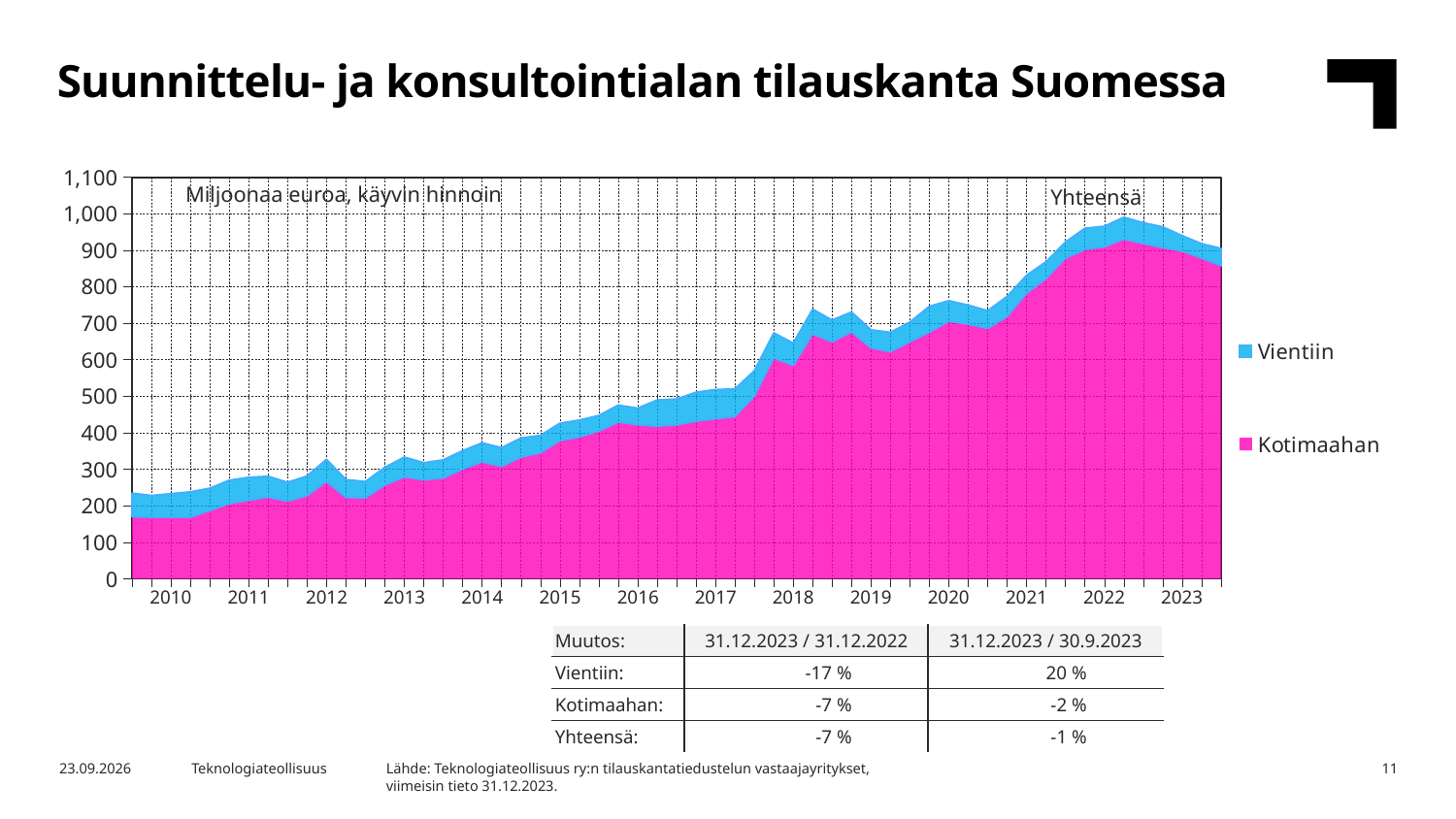
What unit label is printed inside the chart area at the top left? Miljoonaa euroa, käyvin hinnoin What are the two series named in the chart legend? Vientiin and Kotimaahan How many series does the chart legend list? 2 Does the total order backlog generally rise or fall from 2010 to 2022? rise Which series is shown in magenta (the lower area)? Kotimaahan Is the total (Yhteensä) at its 2022 peak greater or less than 900? greater What kind of chart is shown on the slide? Stacked area chart Is the total (Yhteensä) at the start of 2018 greater or less than 600? greater Is the total (Yhteensä) at the start of 2010 greater or less than 300? less In which year is the total (Yhteensä) at its lowest level? 2010 In which year does the total (Yhteensä) reach its highest level? 2022